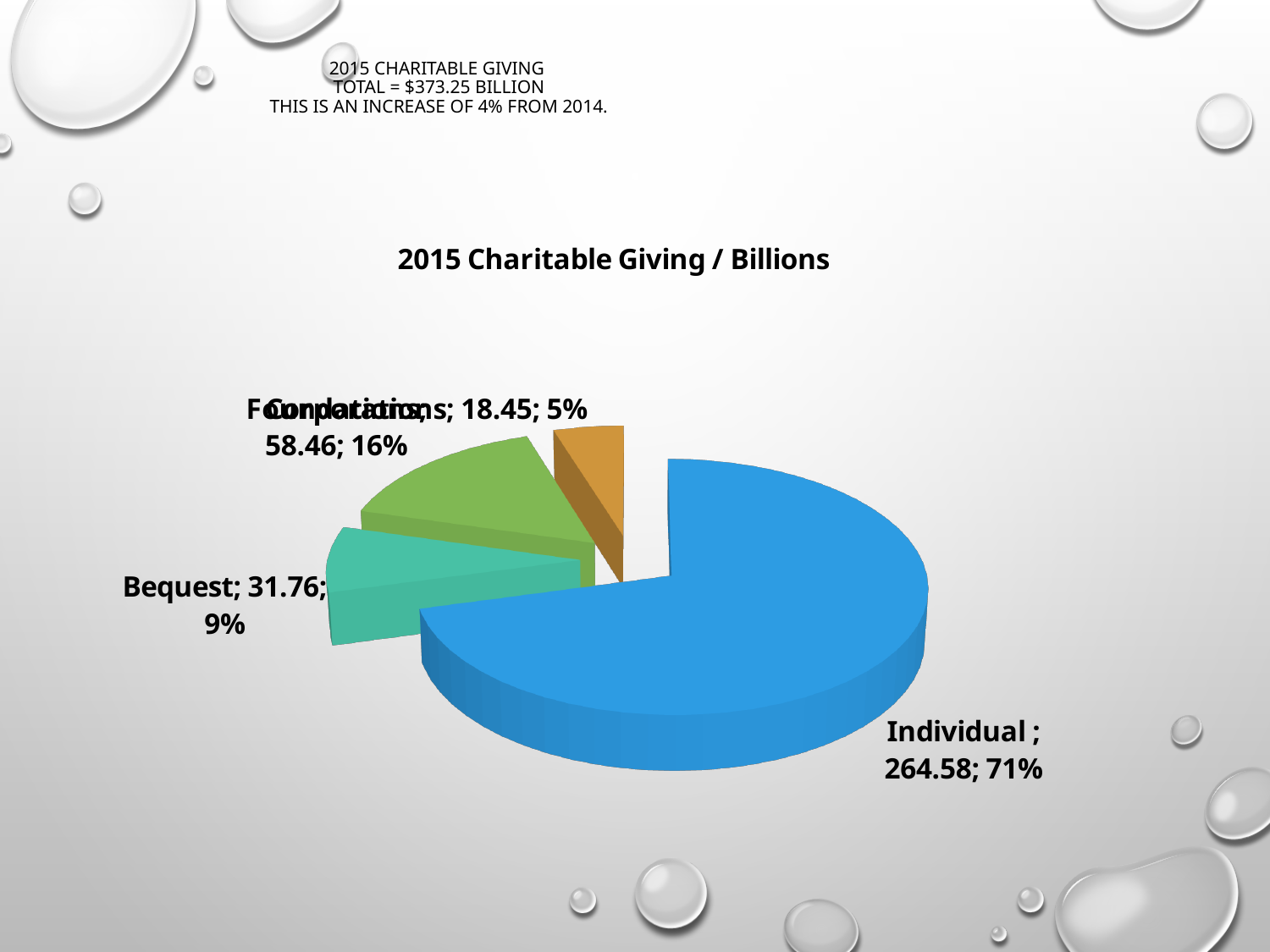
What share of the pie does Individual represent? 71% Which category has the largest slice of the pie? Individual Which is larger, the value for Individual or the value for Bequest? Individual What is the value for Individual? 264.58 What is the value for Bequest? 31.76 What is the smallest percentage share shown on the pie chart? 5% What is the title of the chart? 2015 Charitable Giving / Billions What kind of chart is shown on the slide? pie chart What is the difference between the values for Individual and Bequest? 232.82 What share of the pie does Bequest represent? 9% How many slices does the pie chart have? 4 What colour is the Individual slice? blue